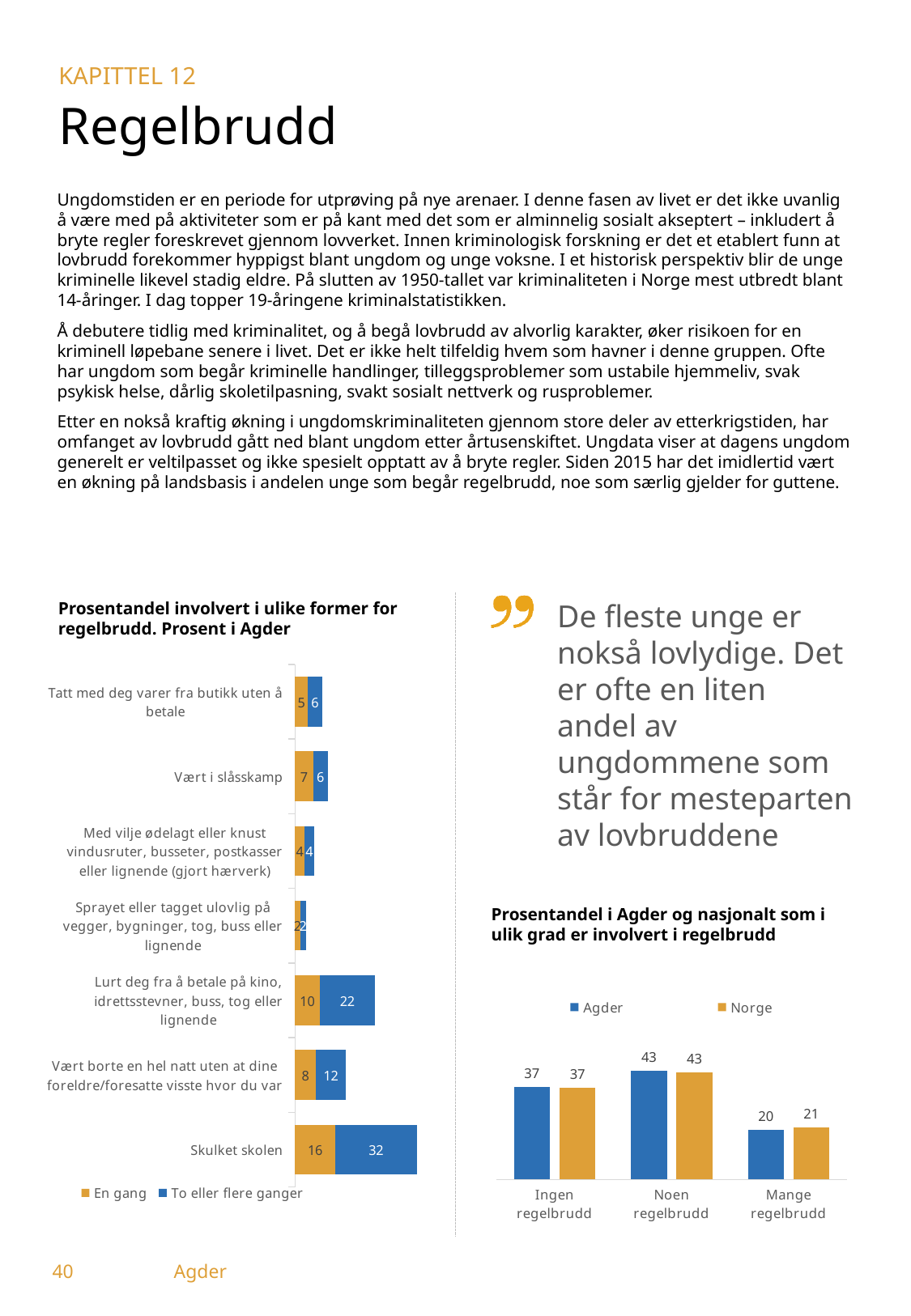
In the chart 'Prosentandel involvert i ulike former for regelbrudd. Prosent i Agder', what is the value of 'En gang' for 'Lurt deg fra å betale på kino, idrettsstevner, buss, tog eller lignende'? 10 In the chart 'Prosentandel involvert i ulike former for regelbrudd. Prosent i Agder', how many categories are shown? 7 In the chart 'Prosentandel involvert i ulike former for regelbrudd. Prosent i Agder', what is the total of the stacked bar for 'Skulket skolen'? 48 In the chart 'Prosentandel involvert i ulike former for regelbrudd. Prosent i Agder', how many series does the legend list? 2 In the chart 'Prosentandel i Agder og nasjonalt som i ulik grad er involvert i regelbrudd', what is the value for Norge in 'Mange regelbrudd'? 21 In the chart 'Prosentandel i Agder og nasjonalt som i ulik grad er involvert i regelbrudd', which colour represents Norge? Orange In the chart 'Prosentandel i Agder og nasjonalt som i ulik grad er involvert i regelbrudd', which category has the highest value for Agder? Noen regelbrudd In the chart 'Prosentandel involvert i ulike former for regelbrudd. Prosent i Agder', what is the total of the stacked bar for 'Vært borte en hel natt uten at dine foreldre/foresatte visste hvor du var'? 20 In the chart 'Prosentandel i Agder og nasjonalt som i ulik grad er involvert i regelbrudd', what is the difference between Agder's values for 'Noen regelbrudd' and 'Mange regelbrudd'? 23 In the chart 'Prosentandel involvert i ulike former for regelbrudd. Prosent i Agder', which category has the highest total? Skulket skolen What kind of chart is 'Prosentandel involvert i ulike former for regelbrudd. Prosent i Agder'? Stacked bar chart In the chart 'Prosentandel involvert i ulike former for regelbrudd. Prosent i Agder', what is the value of 'To eller flere ganger' for 'Skulket skolen'? 32